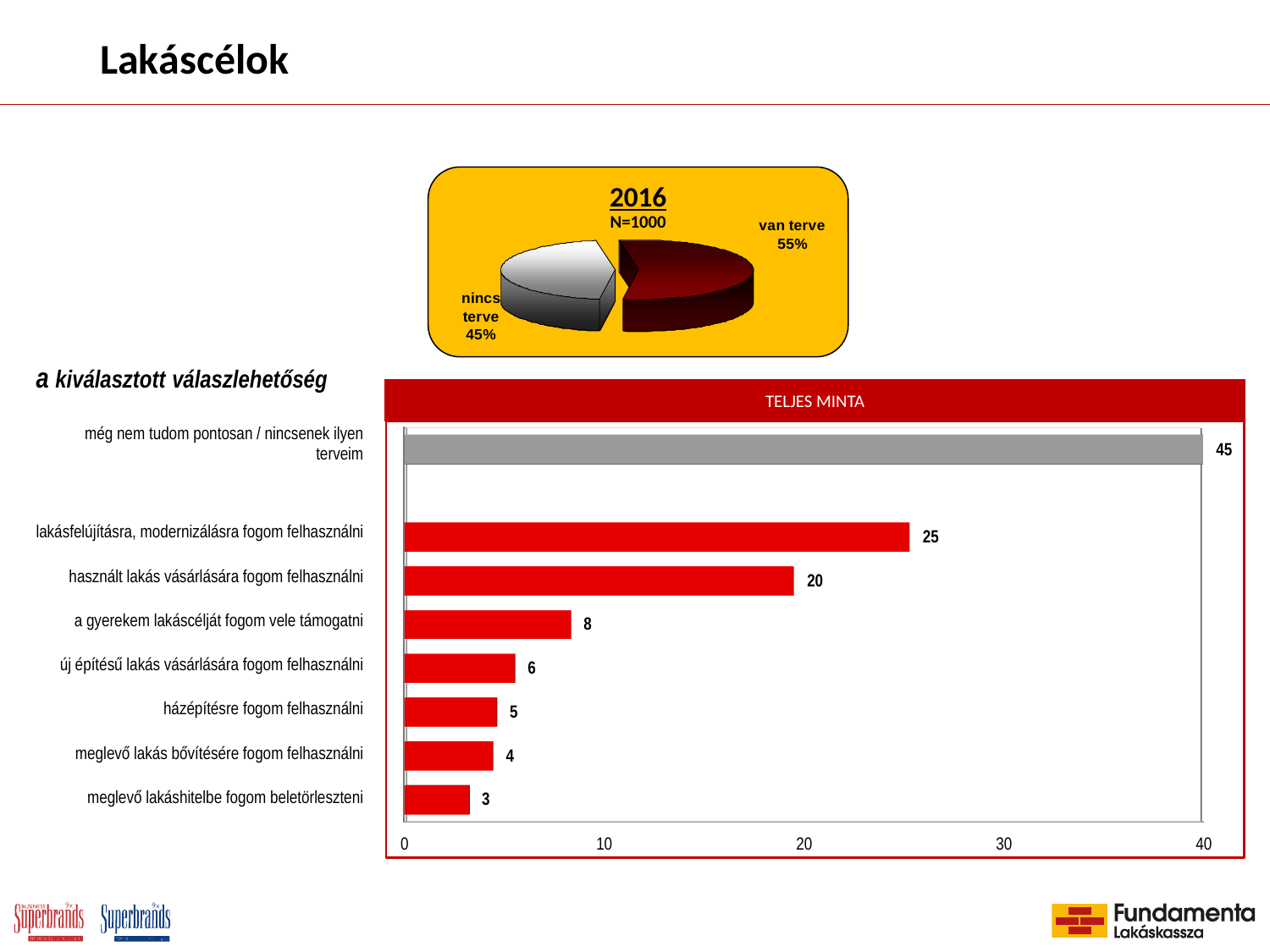
In the bar chart "TELJES MINTA", what is the difference between the values for "lakásfelújításra, modernizálásra fogom felhasználni" and "használt lakás vásárlására fogom felhasználni"? 5 In the bar chart "TELJES MINTA", which category has the lowest value? meglevő lakáshitelbe fogom beletörleszteni In the bar chart "TELJES MINTA", what is the value for "lakásfelújításra, modernizálásra fogom felhasználni"? 25 In the pie chart, which slice is larger, "van terve" or "nincs terve"? van terve In the pie chart, what sample size (N) is shown? N=1000 In the pie chart, what share is labelled "nincs terve"? 45% In the bar chart "TELJES MINTA", how many categories are plotted? 8 In the pie chart, what share is labelled "van terve"? 55% In the bar chart "TELJES MINTA", which category has the highest value? még nem tudom pontosan / nincsenek ilyen terveim What kind of chart is the "TELJES MINTA" chart? bar chart In the bar chart "TELJES MINTA", what is the value for "használt lakás vásárlására fogom felhasználni"? 20 In the bar chart "TELJES MINTA", is the value for "a gyerekem lakáscélját fogom vele támogatni" greater or less than 10? less